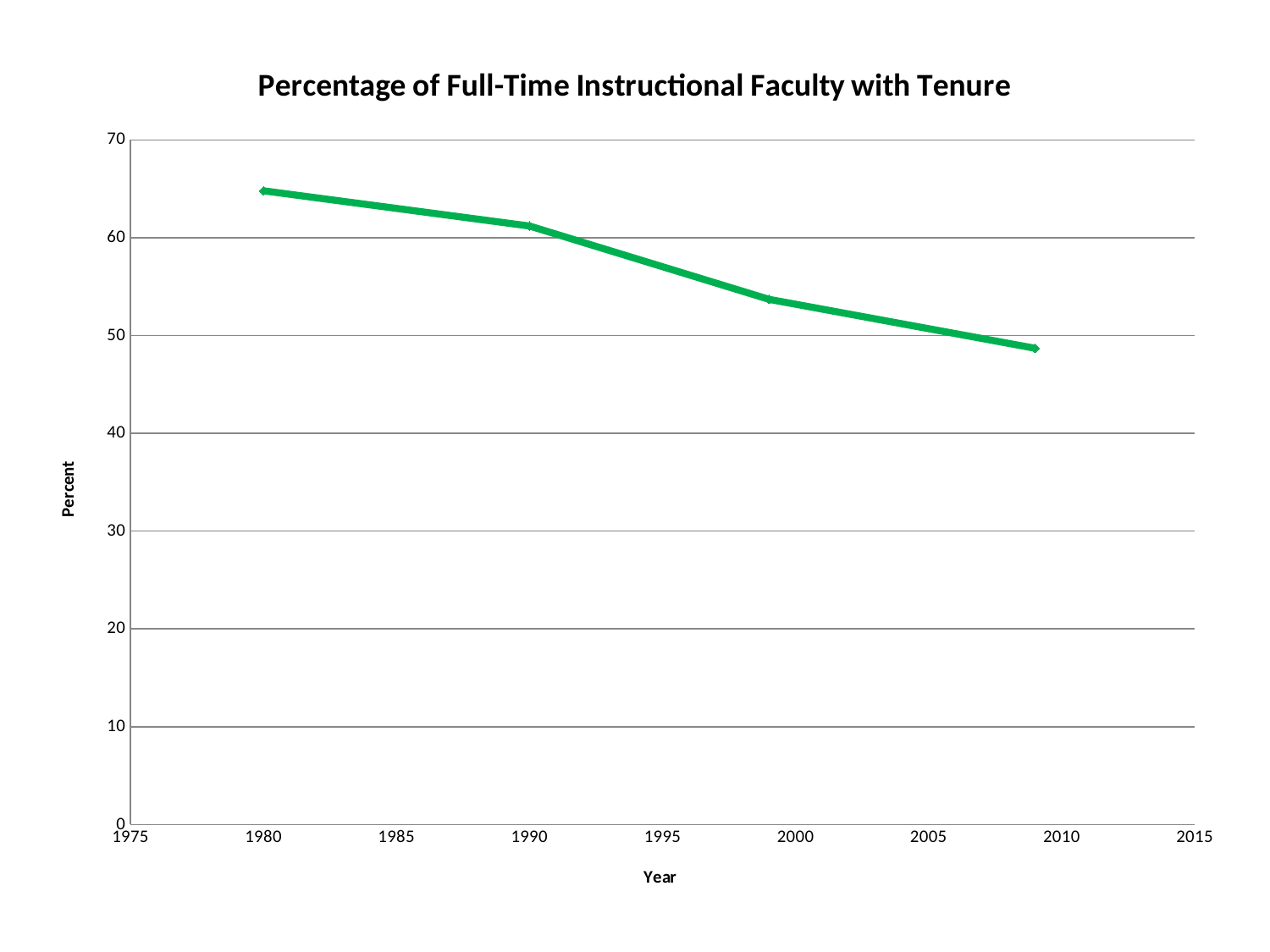
Is the lowest value on the line at the first or the last plotted point? last What is the label of the vertical axis? Percent How many data points are plotted on the line? 4 Is the value for 1980 greater or less than 60? greater Is the value at the third plotted point (just before 2000) greater or less than 50? greater Do the values rise or fall as the year increases? fall Which year has the larger value, 1980 or 1990? 1980 What kind of chart is shown on the slide? line chart In which year is the percentage of faculty with tenure highest? 1980 What is the title of the chart? Percentage of Full-Time Instructional Faculty with Tenure Is the value at the last plotted point greater or less than 50? less